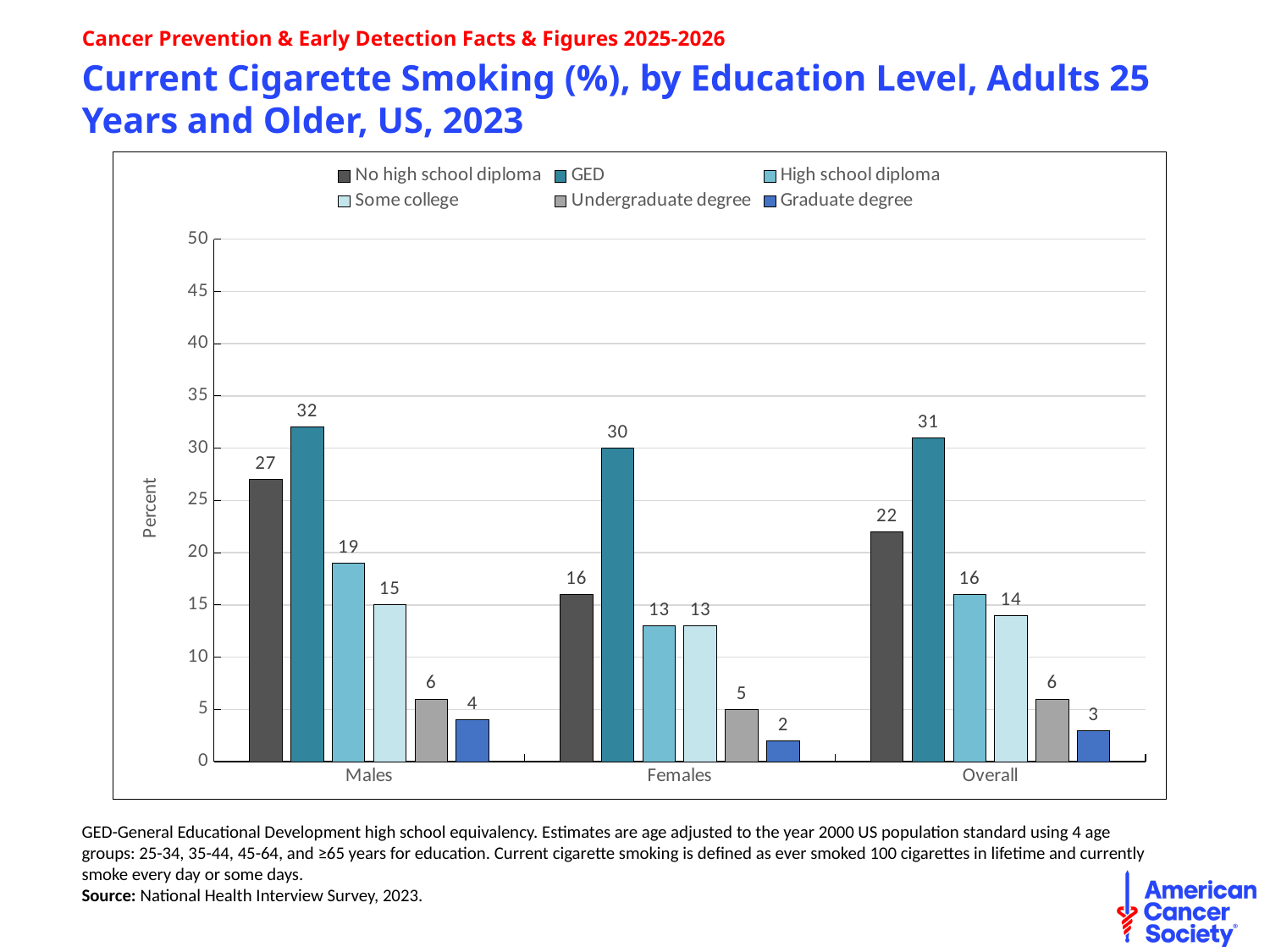
What kind of chart is shown on the slide? Bar chart Which education level has the highest smoking percentage among females? GED What is the label of the y axis? Percent Which is larger: the high school diploma value for males or for females? Males How many groups are shown on the x axis? 3 What is the value for females with no high school diploma? 16 What is the overall value for adults with a graduate degree? 3 How many series does the legend list? 6 Which education level has the lowest smoking percentage among males? Graduate degree What is the difference between the GED value and the no high school diploma value for males? 5 What is the current cigarette smoking percentage for males with a GED? 32 What is the difference between the overall GED value and the overall undergraduate degree value? 25